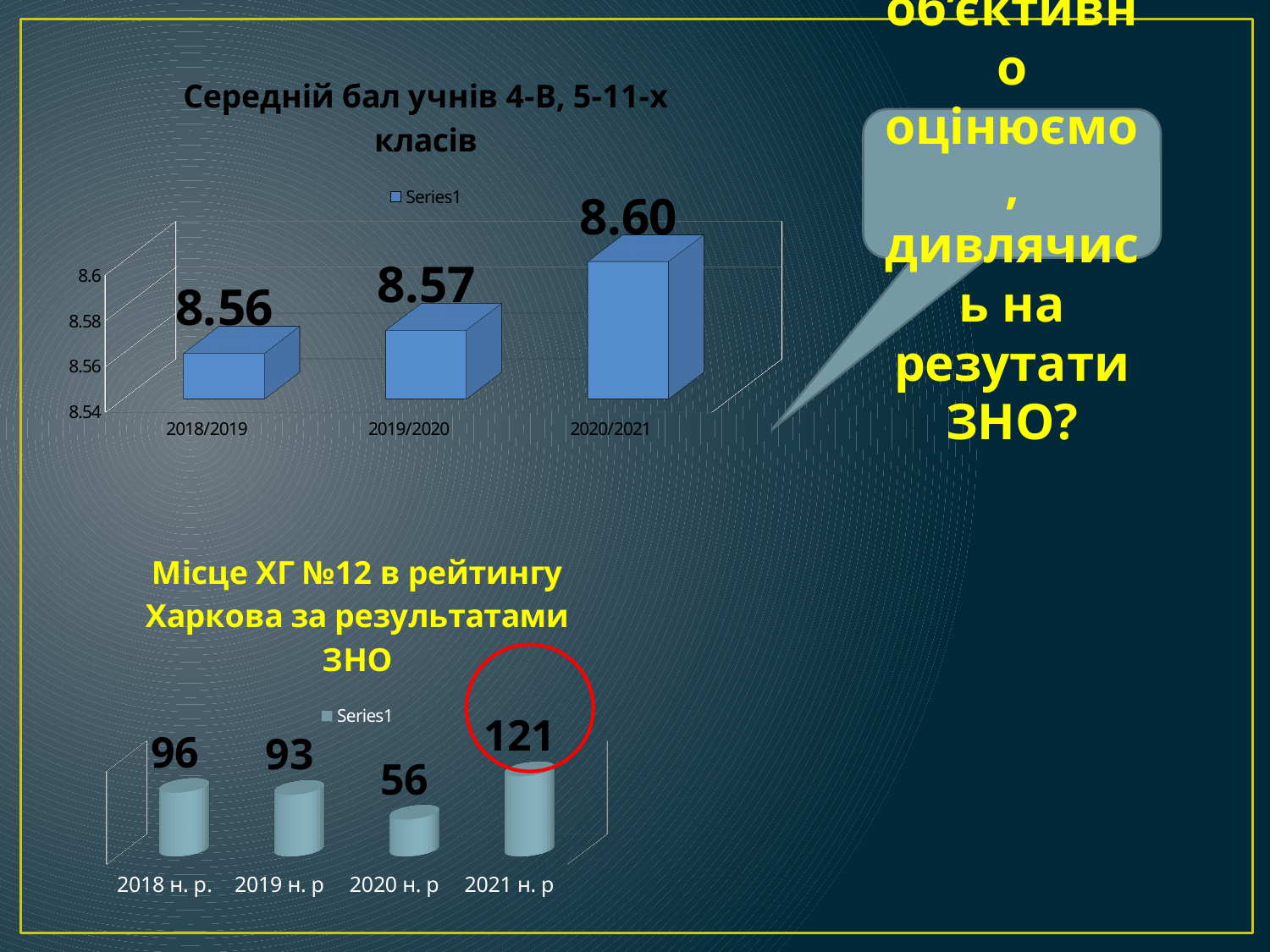
In the bottom chart 'Місце ХГ №12 в рейтингу Харкова за результатами ЗНО', how many years are plotted? 4 What type of chart is the bottom chart 'Місце ХГ №12 в рейтингу Харкова за результатами ЗНО'? bar chart In the top chart 'Середній бал учнів 4-В, 5-11-х класів', how many school years are plotted? 3 In the top chart 'Середній бал учнів 4-В, 5-11-х класів', which school year has the highest value? 2020/2021 In the top chart 'Середній бал учнів 4-В, 5-11-х класів', do the values rise or fall from 2018/2019 to 2020/2021? rise In the bottom chart 'Місце ХГ №12 в рейтингу Харкова за результатами ЗНО', what is the value for 2021 н. р? 121 In the top chart 'Середній бал учнів 4-В, 5-11-х класів', what is the value for 2020/2021? 8.60 In the bottom chart 'Місце ХГ №12 в рейтингу Харкова за результатами ЗНО', what is the difference between the values for 2021 н. р and 2020 н. р? 65 In the bottom chart 'Місце ХГ №12 в рейтингу Харкова за результатами ЗНО', which year has the lowest value? 2020 н. р In the bottom chart 'Місце ХГ №12 в рейтингу Харкова за результатами ЗНО', which is larger, the value for 2018 н. р. or 2019 н. р? 2018 н. р. In the top chart 'Середній бал учнів 4-В, 5-11-х класів', what is the difference between the values for 2020/2021 and 2019/2020? 0.03 In the top chart 'Середній бал учнів 4-В, 5-11-х класів', what is the value for 2018/2019? 8.56